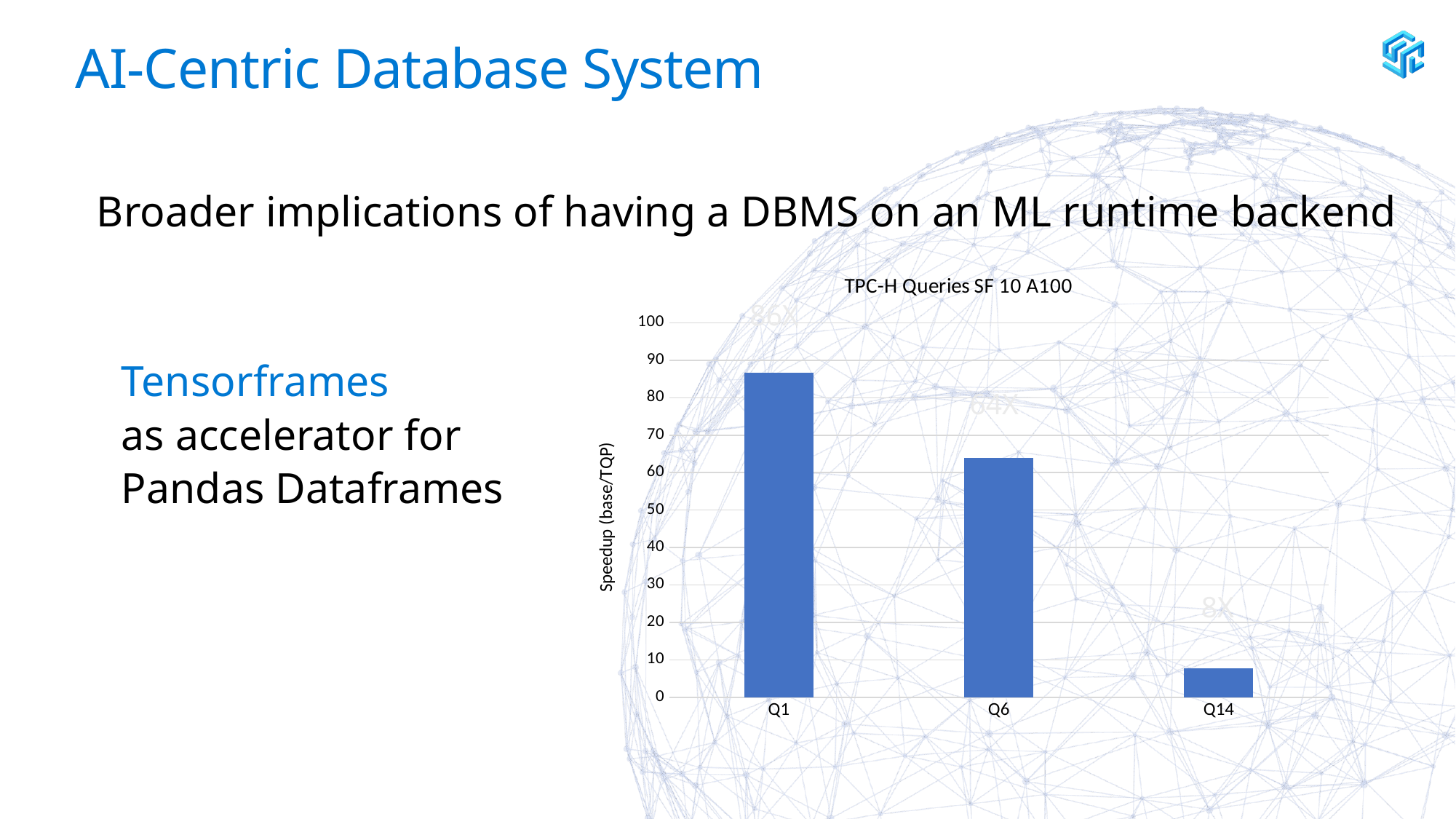
How many queries (categories) are plotted in the TPC-H Queries SF 10 A100 chart? 3 What kind of chart is shown under the title "TPC-H Queries SF 10 A100"? bar chart Is the speedup for Q1 greater or less than 90? less Is the speedup for Q6 greater or less than 60? greater What is the label on the vertical axis of the chart? Speedup (base/TQP) Do the speedup values rise or fall from Q1 to Q14 along the x axis? fall Which query has the lowest speedup in the TPC-H Queries SF 10 A100 chart? Q14 Is the speedup for Q1 greater or less than 80? greater Which query has the highest speedup in the TPC-H Queries SF 10 A100 chart? Q1 Which has a larger speedup, Q6 or Q14? Q6 What is the title of the chart on the slide? TPC-H Queries SF 10 A100